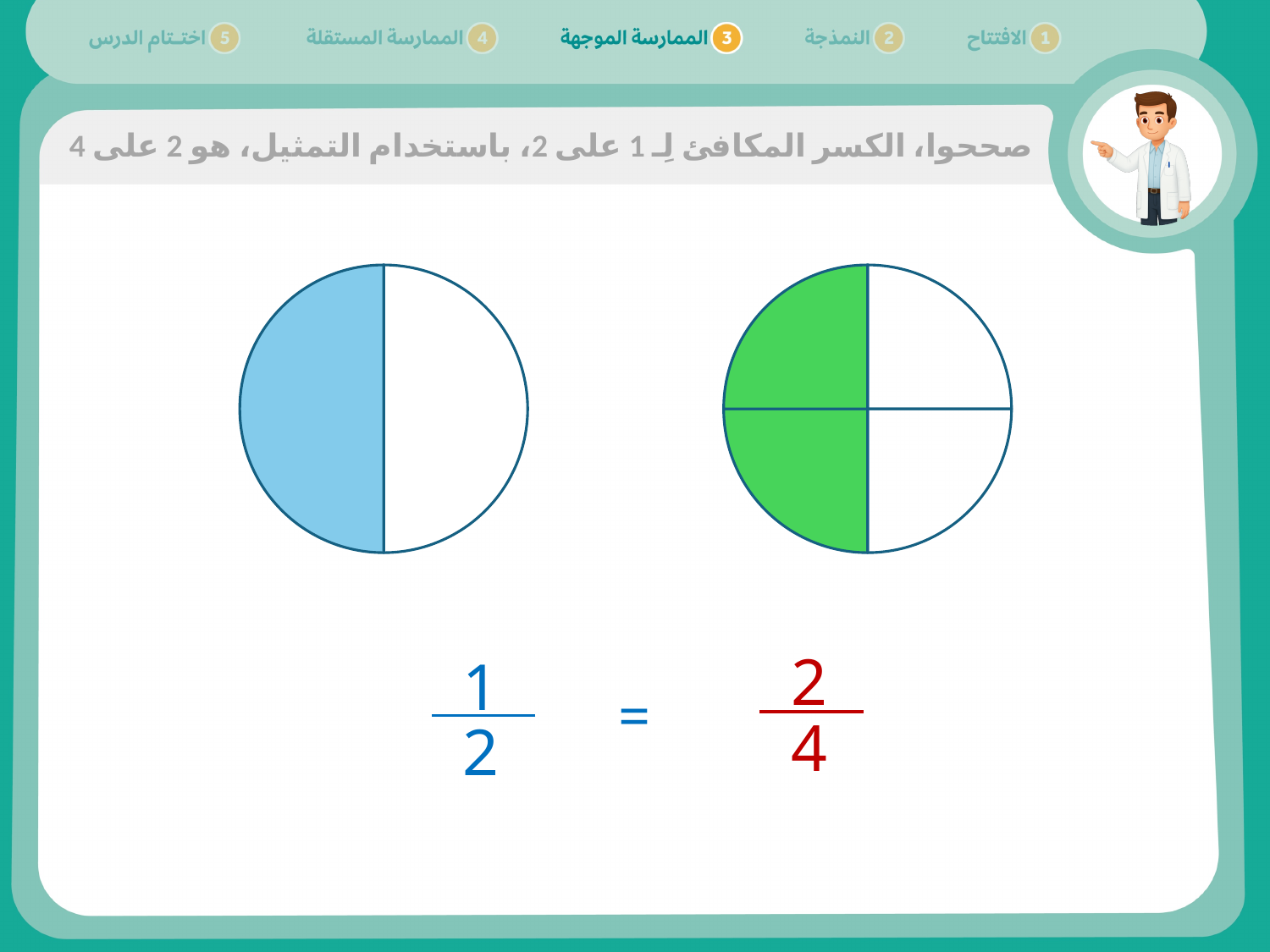
How many equal parts is the right circle divided into? 4 What colour is the shaded part of the right circle? green What colour is the shaded part of the left circle? blue How many parts of the right circle are shaded? 2 How many equal parts is the left circle divided into? 2 What fraction of the left circle is shaded, as printed below it? 1/2 What symbol is printed between the two fractions below the circles? = Is the shaded share of the left circle larger than, smaller than, or equal to the shaded share of the right circle? equal What fraction of the right circle is shaded, as printed below it? 2/4